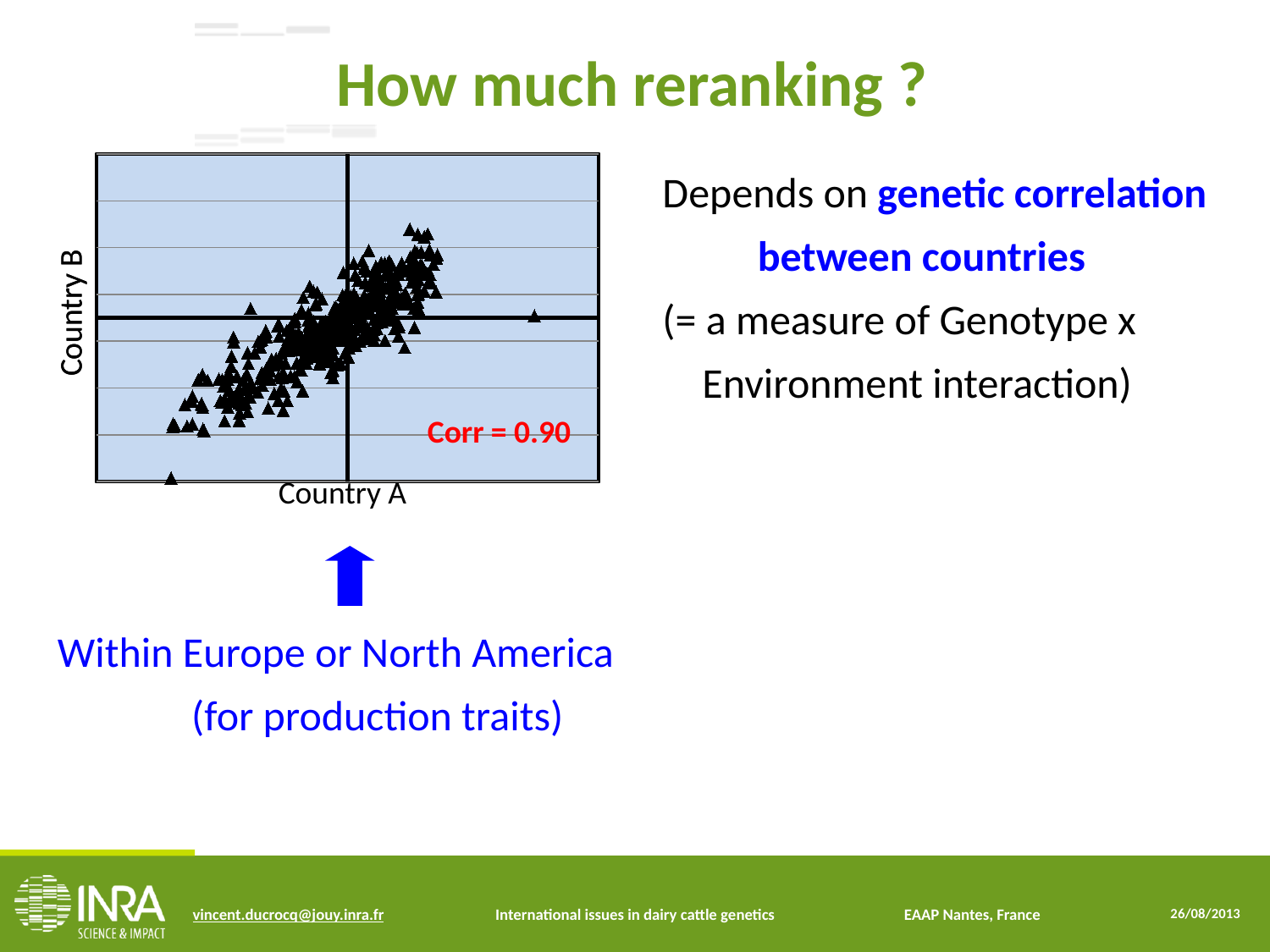
What correlation value is printed on the chart? Corr = 0.90 What kind of chart is shown on the slide? scatter plot What is the label of the horizontal axis of the chart? Country A What is the label of the vertical axis of the chart? Country B As the values for Country A increase along the x axis, do the values for Country B tend to rise or fall? rise